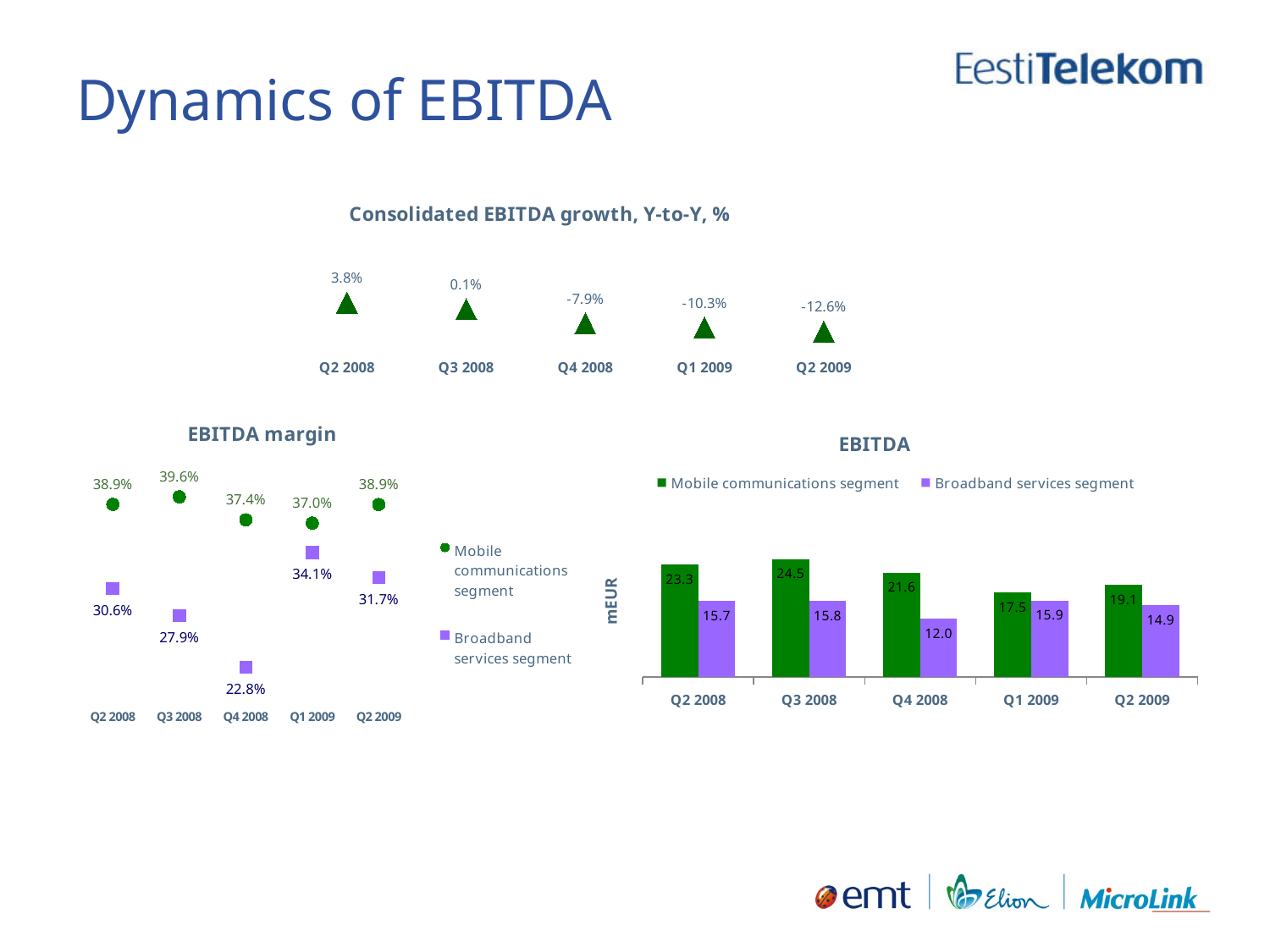
What kind of chart is the 'EBITDA' chart? bar chart In the 'EBITDA' chart, what is the difference between the Mobile communications segment and Broadband services segment values in Q1 2009? 1.6 In the 'EBITDA margin' chart, what is the difference between the Mobile communications segment and Broadband services segment values in Q2 2009? 7.2 percentage points In the 'Consolidated EBITDA growth, Y-to-Y, %' chart, how many quarters are plotted? 5 In the 'EBITDA margin' chart, which quarter has the highest Mobile communications segment value? Q3 2008 In the 'EBITDA' chart, which quarter has the lowest Broadband services segment value? Q4 2008 In the 'EBITDA margin' chart, what is the Broadband services segment value for Q4 2008? 22.8% In the 'Consolidated EBITDA growth, Y-to-Y, %' chart, which quarter has the lowest value? Q2 2009 In the 'EBITDA' chart, what is the Mobile communications segment value for Q3 2008? 24.5 In the 'Consolidated EBITDA growth, Y-to-Y, %' chart, do the values rise or fall from Q2 2008 to Q2 2009? fall In the 'EBITDA margin' chart, how many series does the legend list? 2 In the 'Consolidated EBITDA growth, Y-to-Y, %' chart, what is the value for Q4 2008? -7.9%